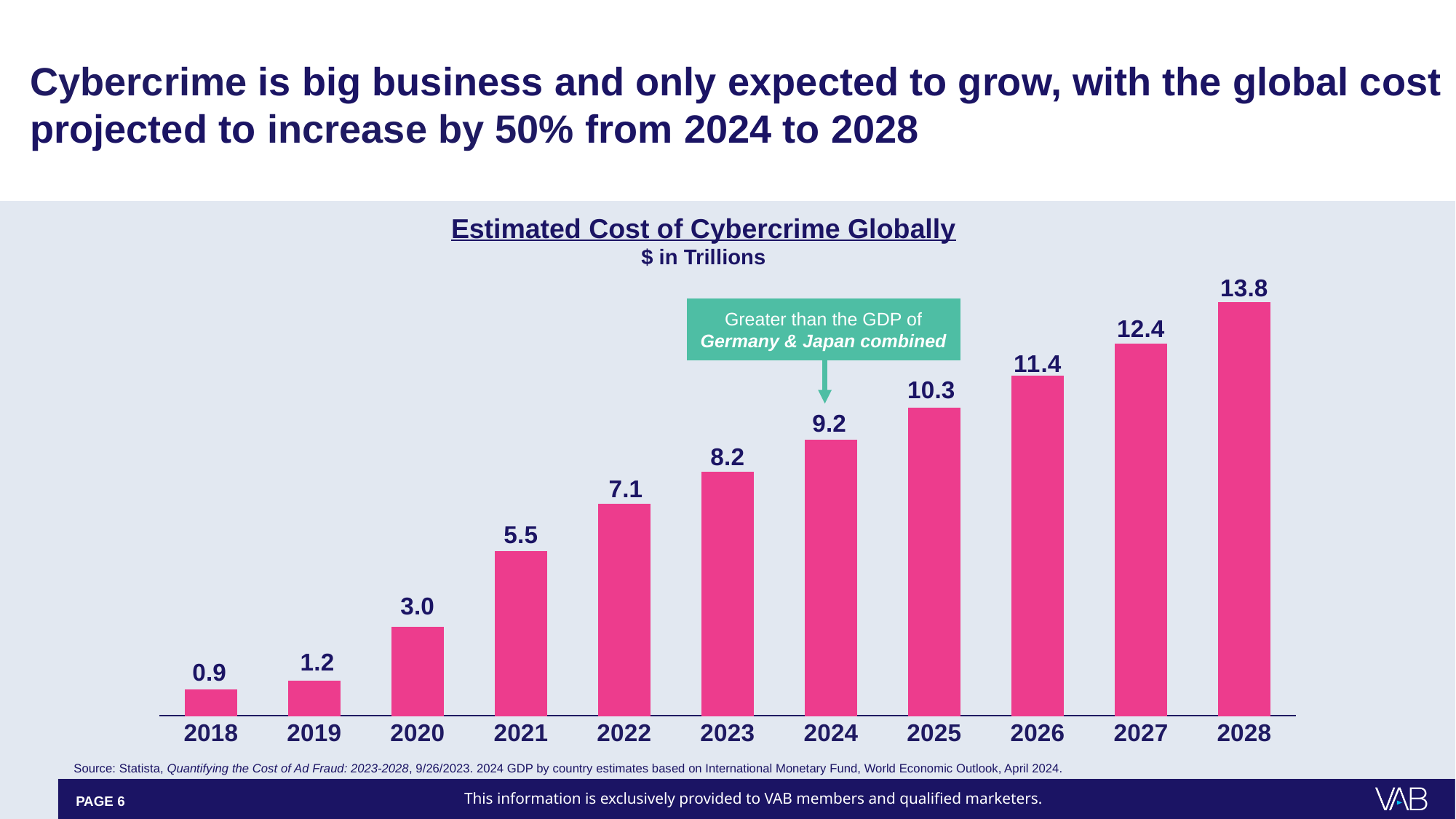
What is the difference between the estimated cost of cybercrime in 2028 and in 2024? 4.6 What kind of chart is used to show the Estimated Cost of Cybercrime Globally? Bar chart Which year has the highest estimated cost of cybercrime globally? 2028 What is the difference between the estimated cost of cybercrime in 2020 and in 2019? 1.8 What is the estimated cost of cybercrime globally for 2018? 0.9 In what unit are the values in the Estimated Cost of Cybercrime Globally chart expressed? $ in Trillions Do the estimated cybercrime cost values rise or fall from 2018 to 2028? Rise What is the estimated cost of cybercrime globally for 2021? 5.5 Which year has a higher estimated cost of cybercrime, 2022 or 2025? 2025 How many years are shown in the Estimated Cost of Cybercrime Globally chart? 11 What is the estimated cost of cybercrime globally for 2024? 9.2 Which year has the lowest estimated cost of cybercrime globally? 2018